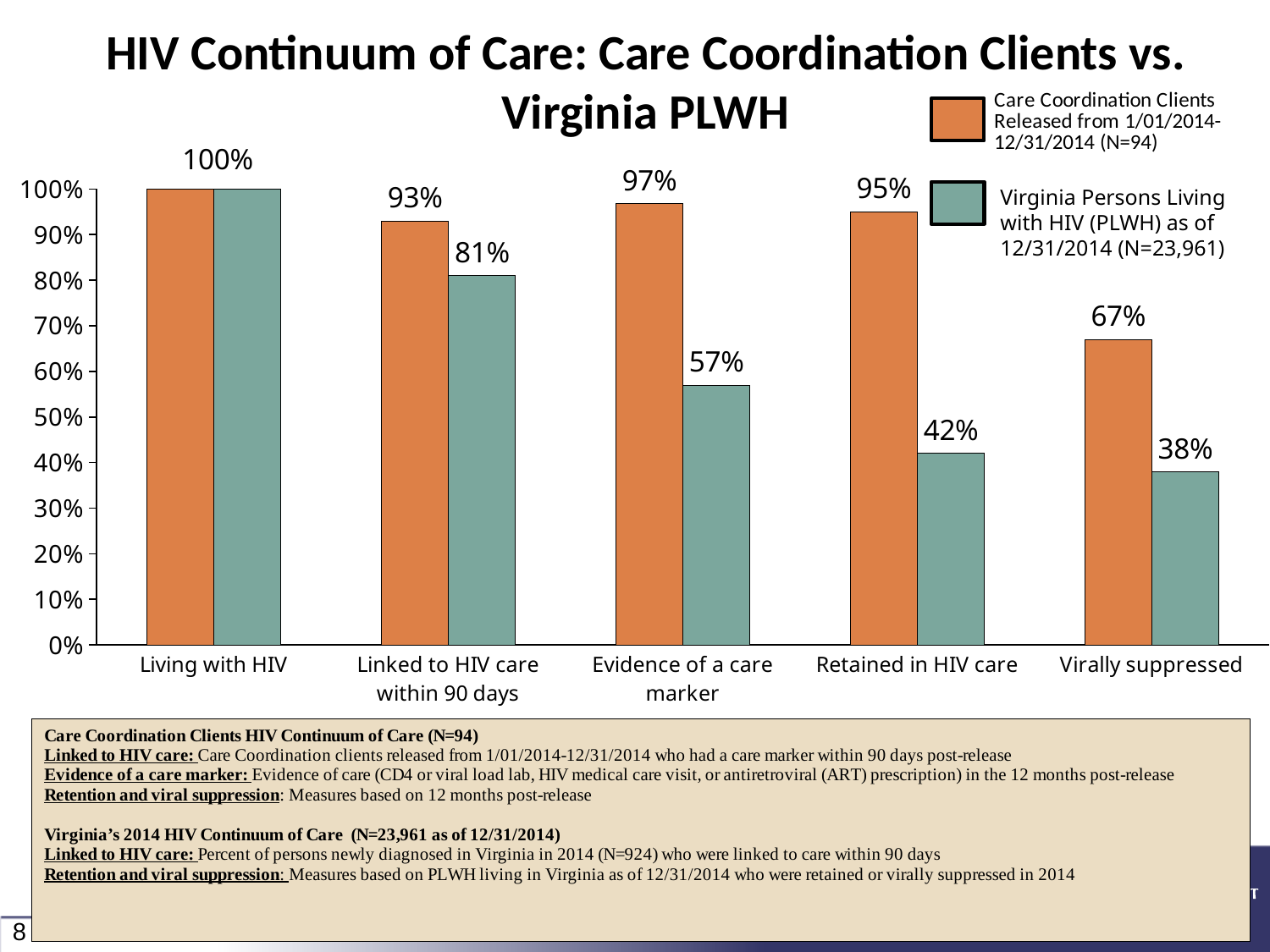
How many categories are shown on the x axis? 5 Which category has the lowest value for Care Coordination Clients? Virally suppressed What kind of chart is shown on the slide? Bar chart What is the difference between Care Coordination Clients and Virginia PLWH in the 'Retained in HIV care' category? 53% How many series does the legend list? 2 What is the value for Virginia PLWH in the 'Retained in HIV care' category? 42% What is the value for Care Coordination Clients in the 'Virally suppressed' category? 67% What is the value for Virginia PLWH in the 'Linked to HIV care within 90 days' category? 81% Which is larger in the 'Evidence of a care marker' category: Care Coordination Clients or Virginia PLWH? Care Coordination Clients What is the difference between Care Coordination Clients and Virginia PLWH in the 'Virally suppressed' category? 29% Which category has the lowest value for Virginia PLWH? Virally suppressed What is the value for Care Coordination Clients in the 'Evidence of a care marker' category? 97%